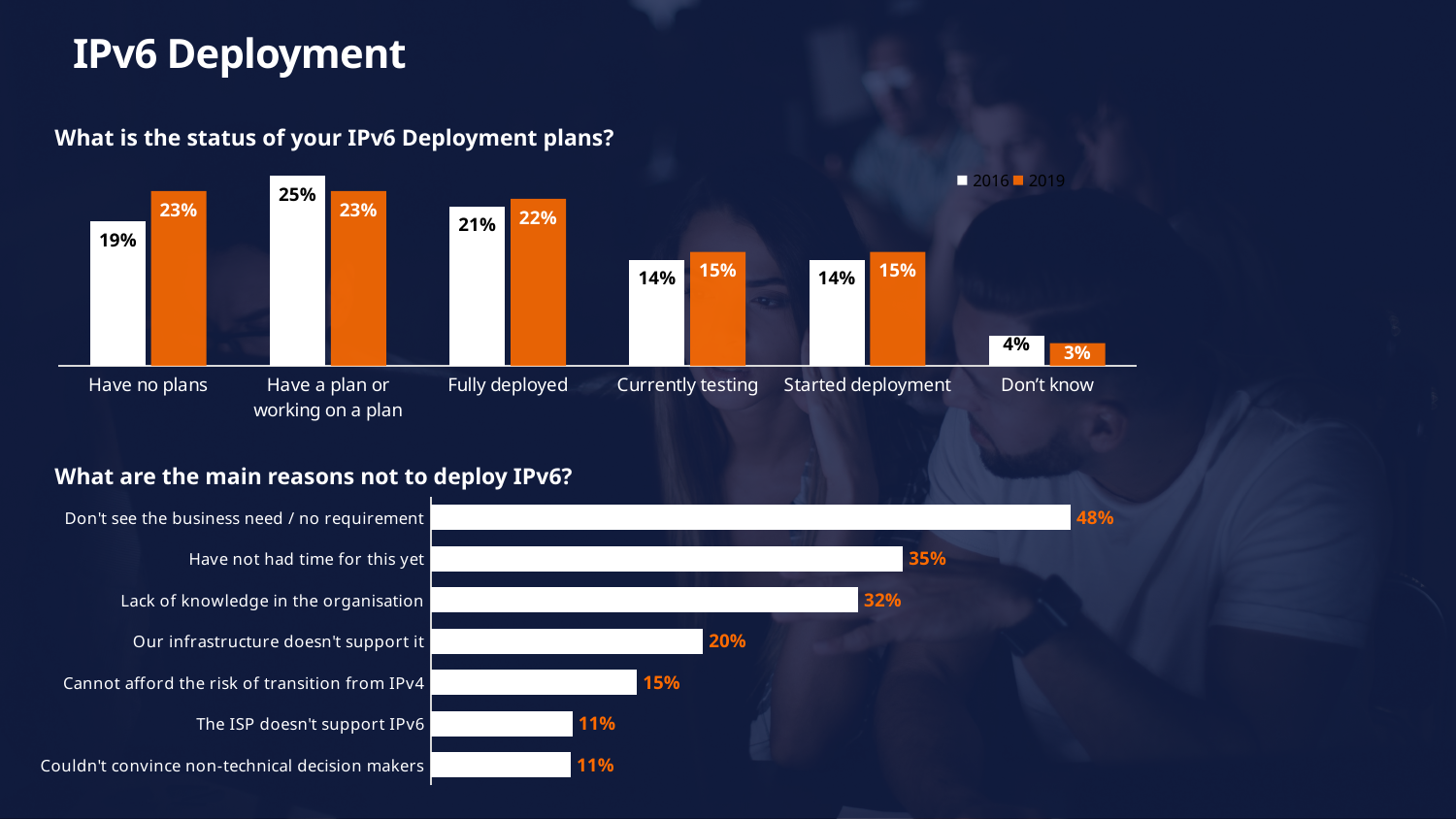
What type of chart is the 'What are the main reasons not to deploy IPv6?' chart? Bar chart In the 'What are the main reasons not to deploy IPv6?' chart, how many reasons are listed? 7 In the 'What is the status of your IPv6 Deployment plans?' chart, what is the 2019 value for 'Have no plans'? 23% In the 'What is the status of your IPv6 Deployment plans?' chart, which category has the lowest 2019 value? Don't know In the 'What is the status of your IPv6 Deployment plans?' chart, which is larger for 'Fully deployed': the 2016 value or the 2019 value? 2019 In the 'What is the status of your IPv6 Deployment plans?' chart, what is the difference between the 2016 and 2019 values for 'Have no plans'? 4% In the 'What is the status of your IPv6 Deployment plans?' chart, what is the 2016 value for 'Have a plan or working on a plan'? 25% In the 'What are the main reasons not to deploy IPv6?' chart, which reason has the highest value? Don't see the business need / no requirement In the 'What is the status of your IPv6 Deployment plans?' chart, how many categories are shown on the x axis? 6 In the 'What is the status of your IPv6 Deployment plans?' chart, how many series does the legend list? 2 In the 'What are the main reasons not to deploy IPv6?' chart, what is the difference between 'Have not had time for this yet' and 'Our infrastructure doesn't support it'? 15% In the 'What are the main reasons not to deploy IPv6?' chart, what is the value for 'Lack of knowledge in the organisation'? 32%